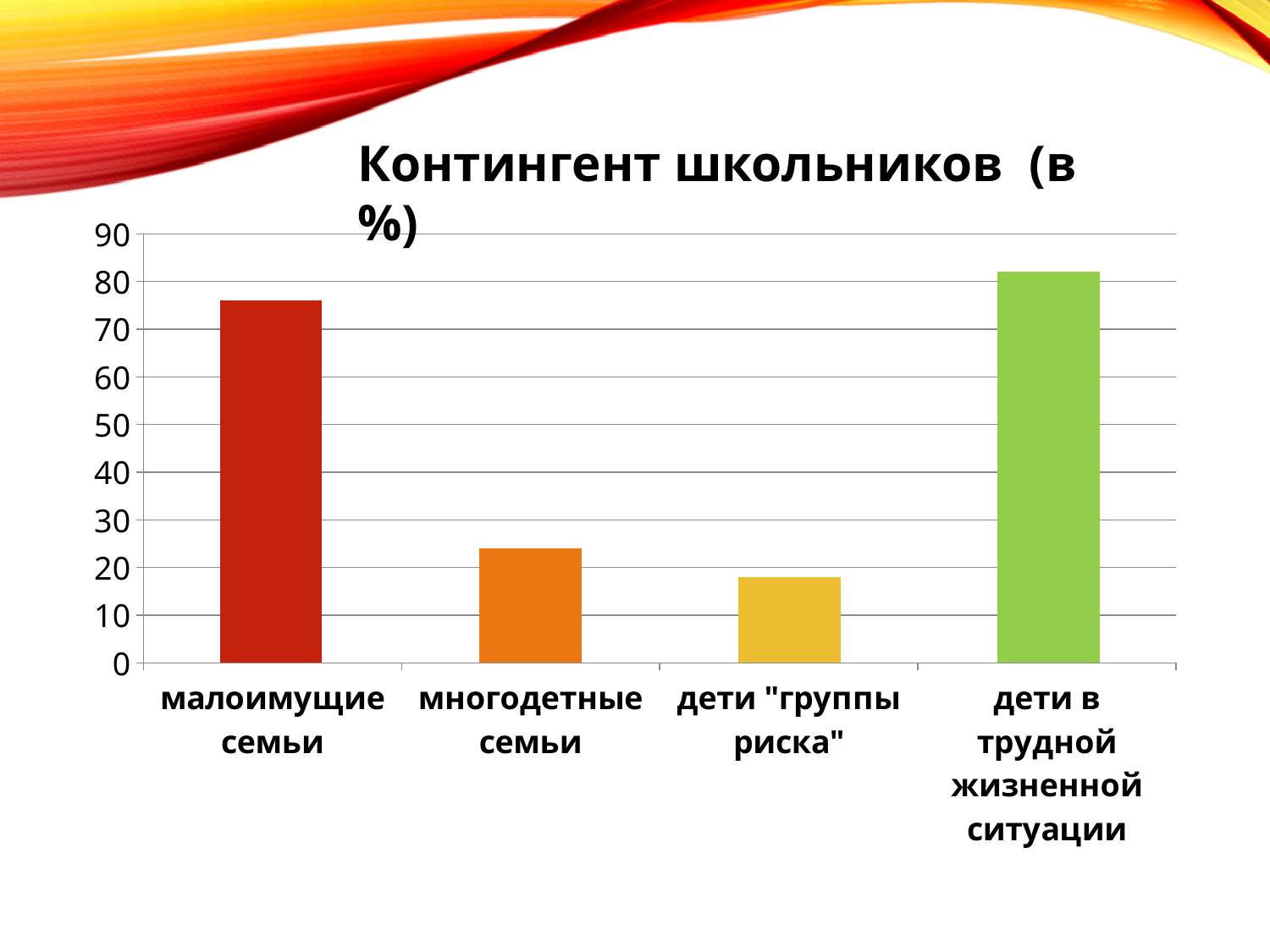
Is the value for дети "группы риска" greater or less than 10? greater What colour is the bar for дети в трудной жизненной ситуации? green Which is larger, the value for дети "группы риска" or the value for дети в трудной жизненной ситуации? дети в трудной жизненной ситуации Which category has the lowest bar? дети "группы риска" How many categories are shown on the x axis of the chart? 4 What kind of chart is shown on the slide? bar chart Which category has the highest bar? дети в трудной жизненной ситуации Is the value for многодетные семьи greater or less than 30? less Which is larger, the value for малоимущие семьи or the value for многодетные семьи? малоимущие семьи Is the value for малоимущие семьи greater or less than 70? greater What is the title of the chart? Контингент школьников (в %)